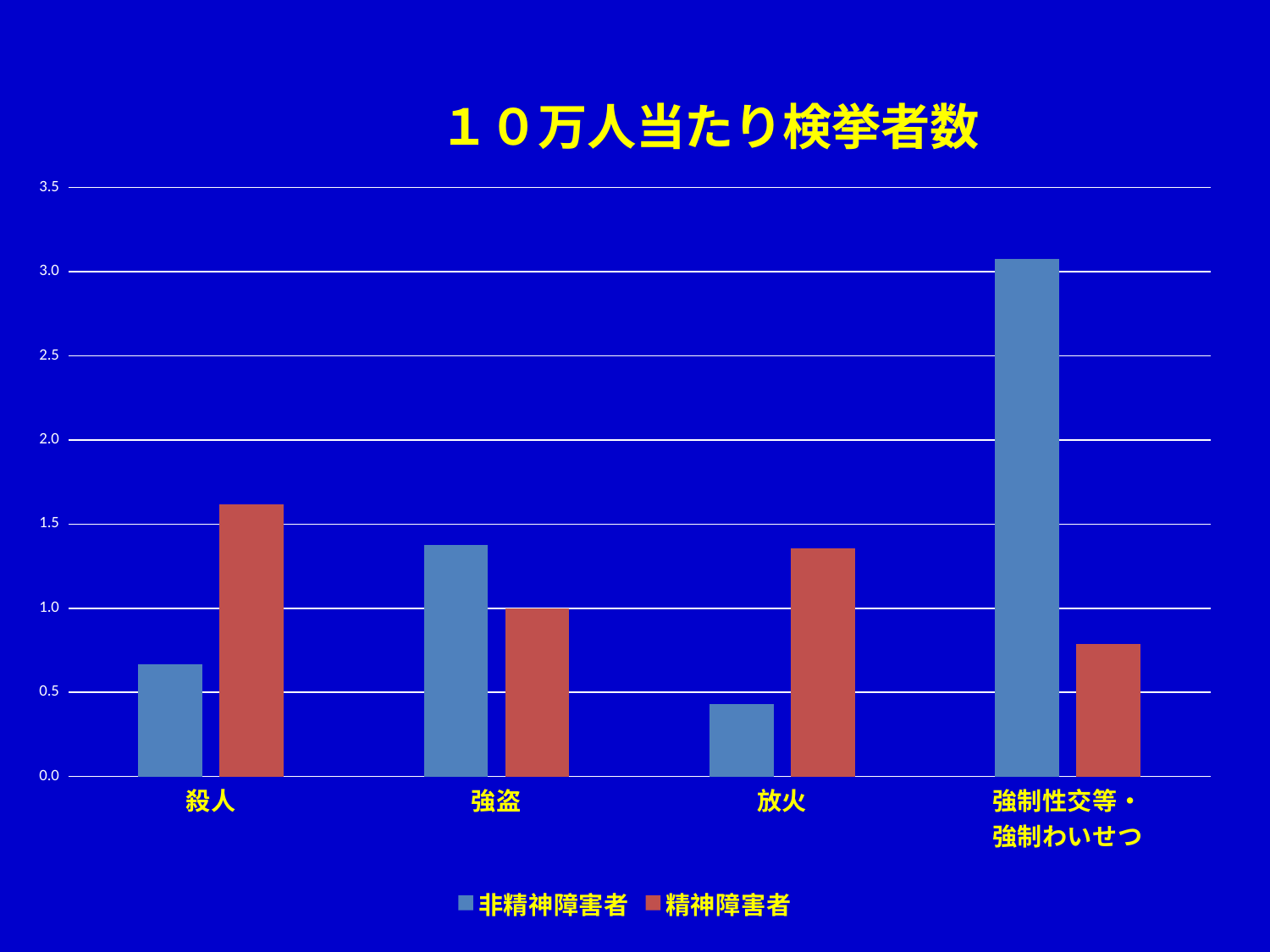
How many categories are shown on the x axis? 4 Which category has the lowest value for 非精神障害者? 放火 Which category has the highest value for 非精神障害者? 強制性交等・強制わいせつ What kind of chart is shown on the slide? bar chart For 殺人, which series has the larger value, 非精神障害者 or 精神障害者? 精神障害者 For 強制性交等・強制わいせつ, which series has the larger value, 非精神障害者 or 精神障害者? 非精神障害者 Which category has the highest value for 精神障害者? 殺人 What is the title of the chart? １０万人当たり検挙者数 Which category has the lowest value for 精神障害者? 強制性交等・強制わいせつ How many series does the legend list? 2 Is the value for 非精神障害者 in 放火 greater or less than 0.5? less Is the value for 非精神障害者 in 強制性交等・強制わいせつ greater or less than 3.0? greater